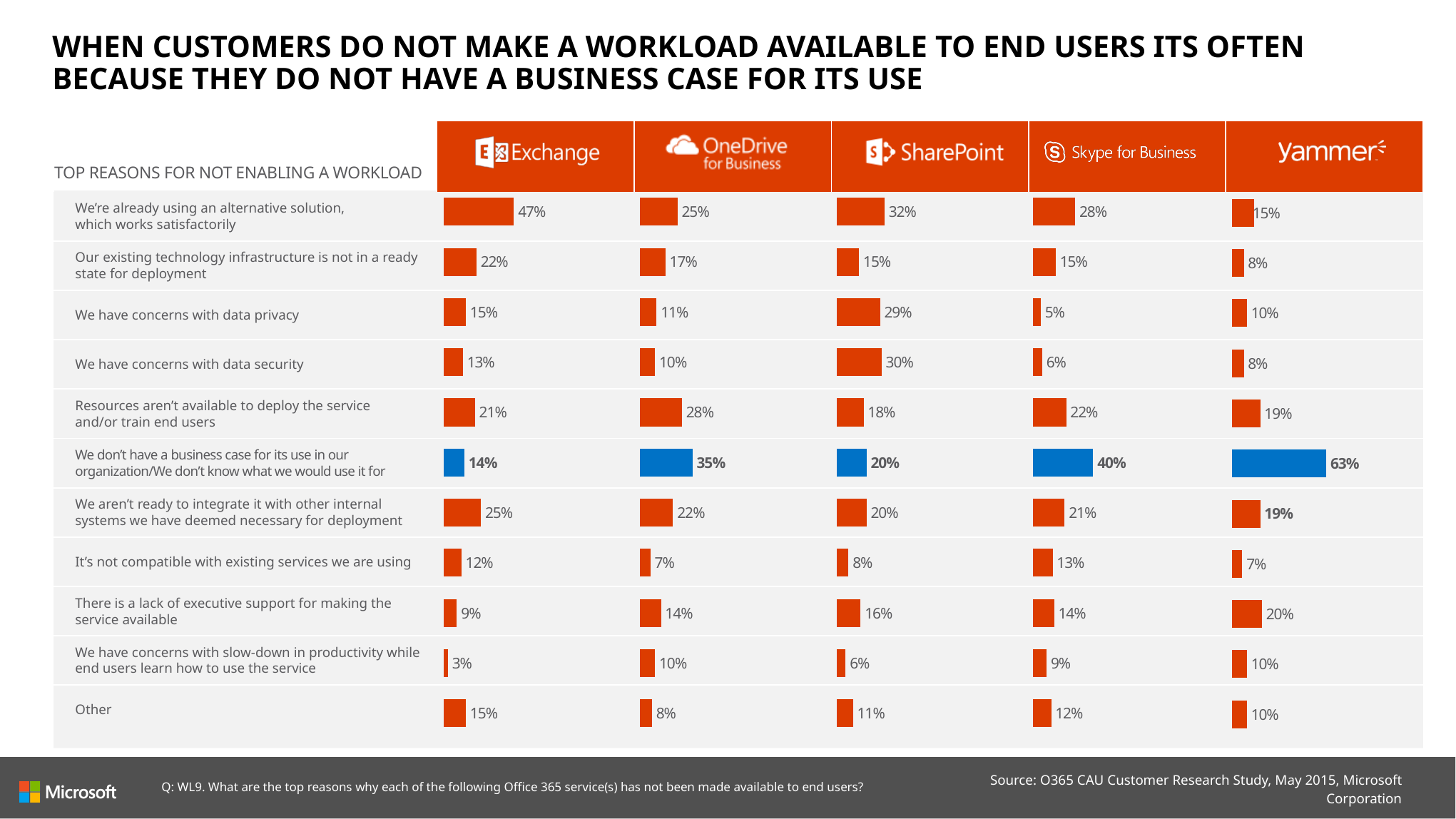
Which is larger for "We have concerns with data privacy": SharePoint or OneDrive for Business? SharePoint Which row of the chart has its bars coloured blue instead of orange? We don't have a business case for its use in our organization/We don't know what we would use it for How many reasons for not enabling a workload are listed in the chart? 11 How many products (columns) are compared in the chart? 5 What is the value for Exchange in the row "We're already using an alternative solution, which works satisfactorily"? 47% For Exchange, which reason has the highest percentage? We're already using an alternative solution, which works satisfactorily What percentage of Yammer customers cite "We don't have a business case for its use in our organization" as a reason for not enabling the workload? 63% What is the difference between Skype for Business and Exchange for "We don't have a business case for its use in our organization"? 26 percentage points What is the value for SharePoint in the row "We have concerns with data security"? 30% Which product has the lowest value for "We have concerns with slow-down in productivity while end users learn how to use the service"? Exchange What kind of chart is used to show the percentages on this slide? Bar chart Which product has the highest value for "We don't have a business case for its use in our organization"? Yammer